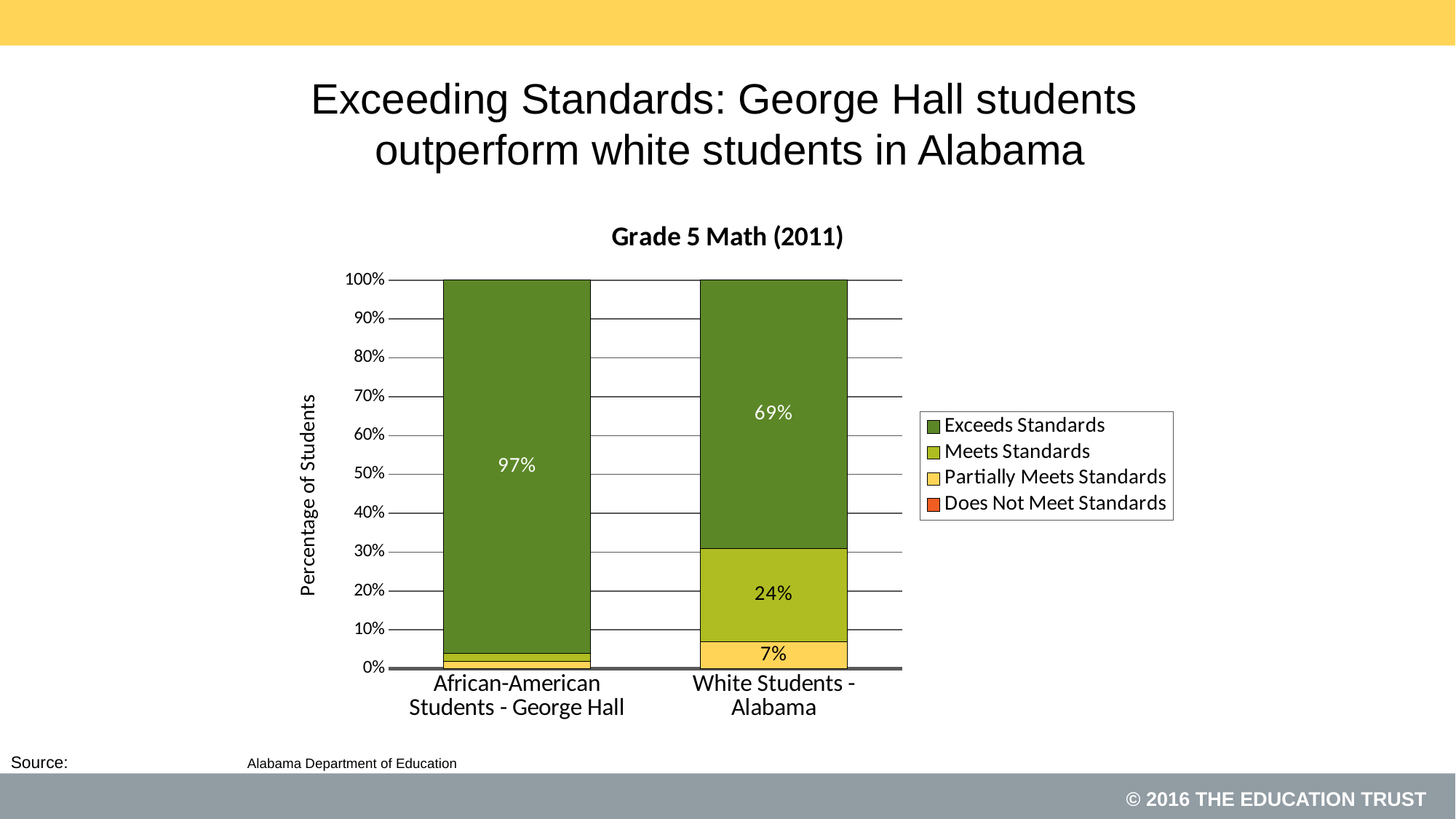
What percentage of white students in Alabama exceed standards in Grade 5 Math (2011)? 69% What kind of chart is shown on the slide? Stacked bar chart Which group has the higher Exceeds Standards percentage: African-American students at George Hall or white students in Alabama? African-American Students - George Hall What is the title of the chart? Grade 5 Math (2011) How many student groups are shown on the x axis of the chart? 2 Is the Meets Standards value for white students in Alabama greater or less than 20%? greater How many series does the chart legend list? 4 What is the difference between the Exceeds Standards percentage for African-American students at George Hall and for white students in Alabama? 28% What is the label on the vertical axis of the chart? Percentage of Students What percentage of white students in Alabama meet standards in Grade 5 Math (2011)? 24% What percentage of white students in Alabama partially meet standards in Grade 5 Math (2011)? 7% What percentage of African-American students at George Hall exceed standards in Grade 5 Math (2011)? 97%